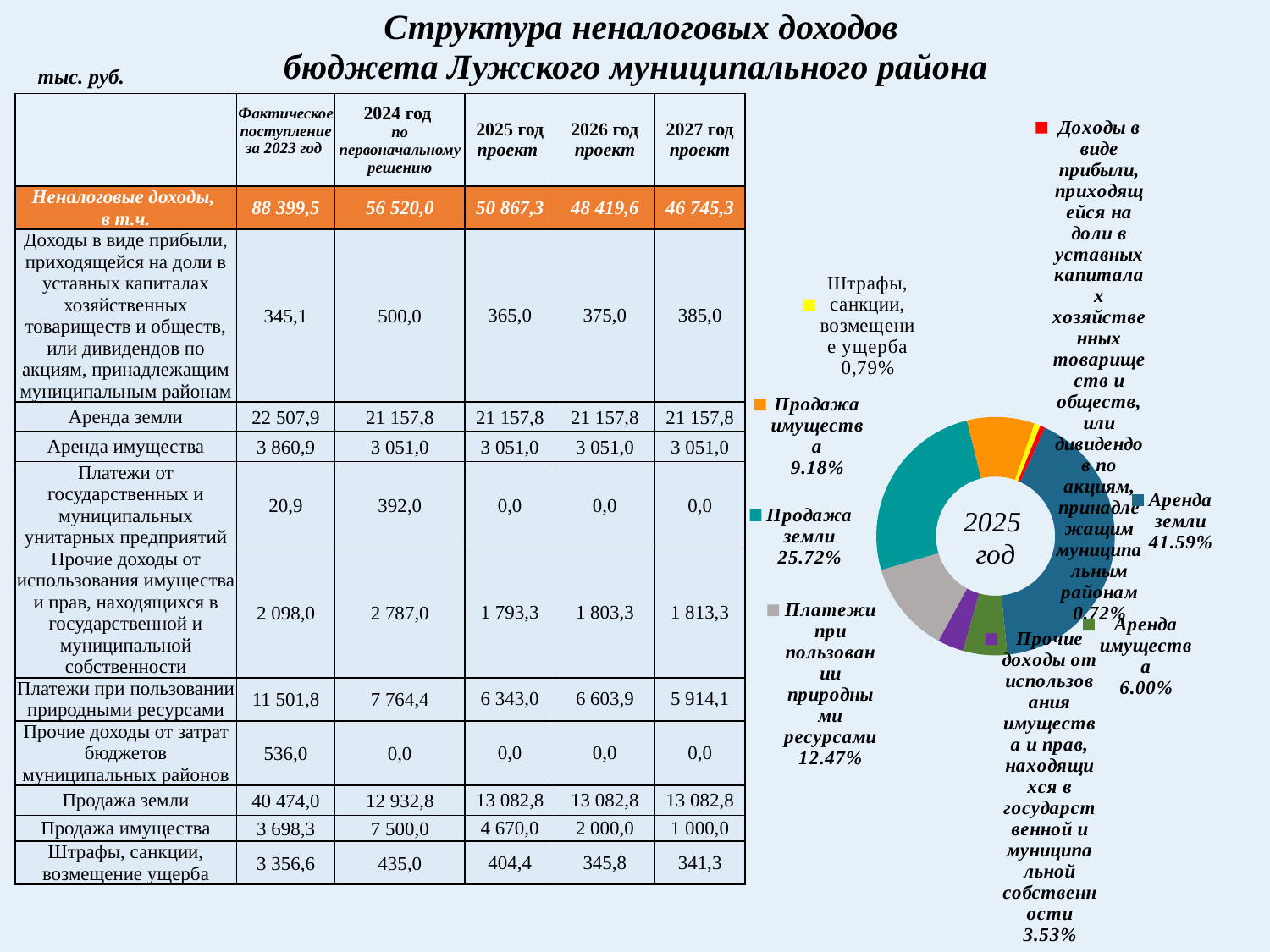
How many slices does the doughnut chart have? 8 Which category has the smallest slice in the doughnut chart? Доходы в виде прибыли, приходящейся на доли в уставных капиталах хозяйственных товариществ и обществ, или дивидендов по акциям, принадлежащим муниципальным районам What share of the doughnut chart is Штрафы, санкции, возмещение ущерба? 0,79% Which category has the largest slice in the doughnut chart? Аренда земли What share of the doughnut chart is Продажа имущества? 9.18% What share of the doughnut chart is Продажа земли? 25.72% Which slice is larger in the doughnut chart: Продажа земли or Продажа имущества? Продажа земли What kind of chart is shown on the right of the slide? doughnut chart What year does the doughnut chart represent, as shown in its centre? 2025 год